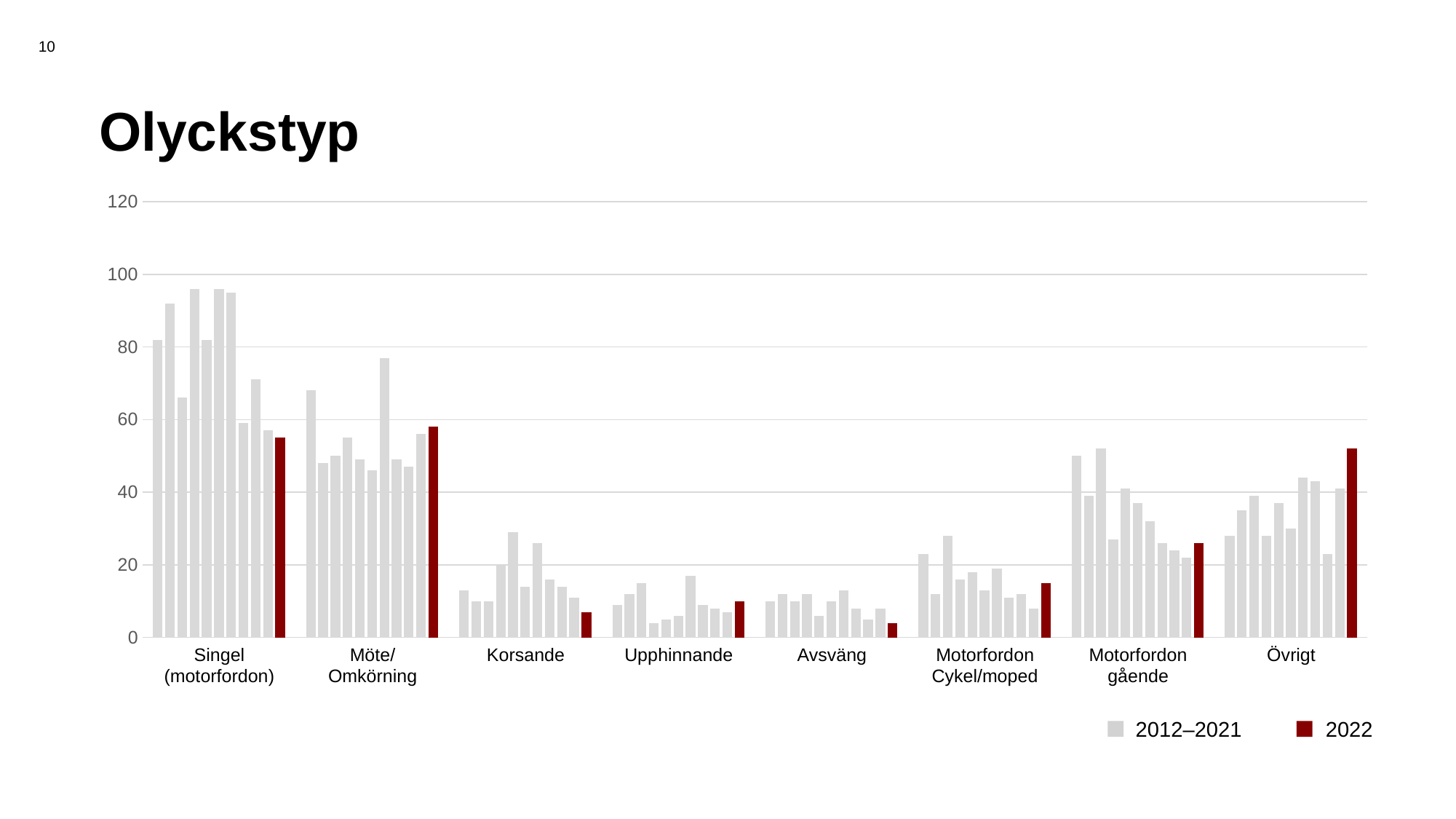
Is the 2022 value for Motorfordon gående greater or less than 20? greater Is the 2022 value for Avsväng greater or less than 20? less Which has the larger 2022 value, Övrigt or Motorfordon gående? Övrigt Which has the larger 2022 value, Möte/Omkörning or Korsande? Möte/Omkörning Is the 2022 value for Övrigt greater or less than 40? greater What kind of chart is shown on the slide? bar chart How many series does the legend list? 2 What is the title of the chart? Olyckstyp How many accident-type categories are shown along the x axis? 8 Which colour represents the 2022 series in the legend? dark red